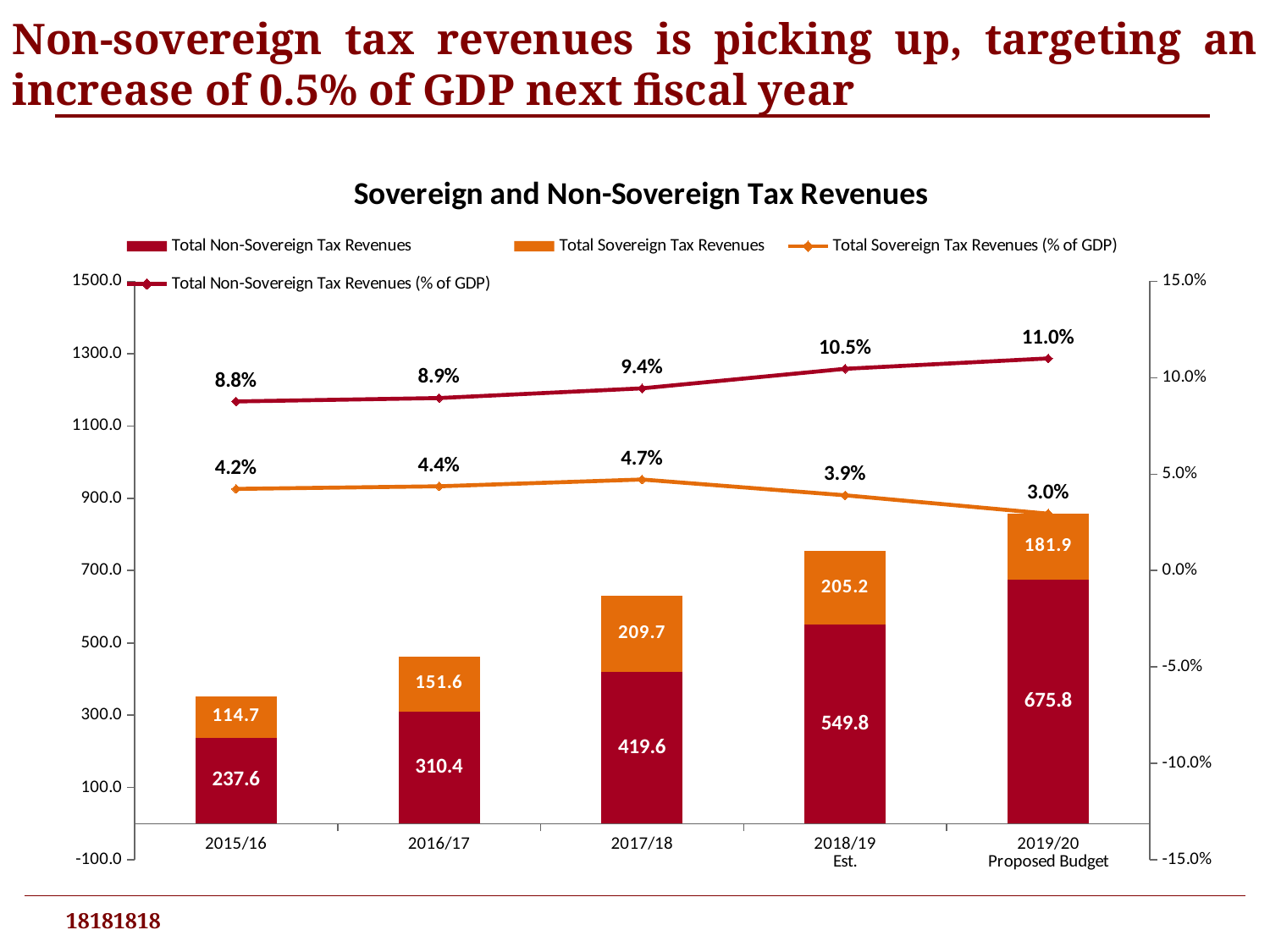
Which is larger: Total Sovereign Tax Revenues in 2018/19 Est. or in 2019/20 Proposed Budget? 2018/19 Est. In which fiscal year is Total Non-Sovereign Tax Revenues lowest? 2015/16 How many series does the legend list? 4 What is the value of Total Non-Sovereign Tax Revenues for 2017/18? 419.6 What is Total Sovereign Tax Revenues (% of GDP) for 2019/20 Proposed Budget? 3.0% What is the difference between Total Non-Sovereign Tax Revenues in 2019/20 Proposed Budget and 2018/19 Est.? 126.0 What is the value of Total Sovereign Tax Revenues for 2016/17? 151.6 What is Total Non-Sovereign Tax Revenues (% of GDP) for 2018/19 Est.? 10.5% What is the total of the stacked bar for 2015/16? 352.3 In which fiscal year is Total Sovereign Tax Revenues highest? 2017/18 Does Total Non-Sovereign Tax Revenues (% of GDP) rise or fall from 2015/16 to 2019/20? rise How many fiscal years are shown on the x axis? 5